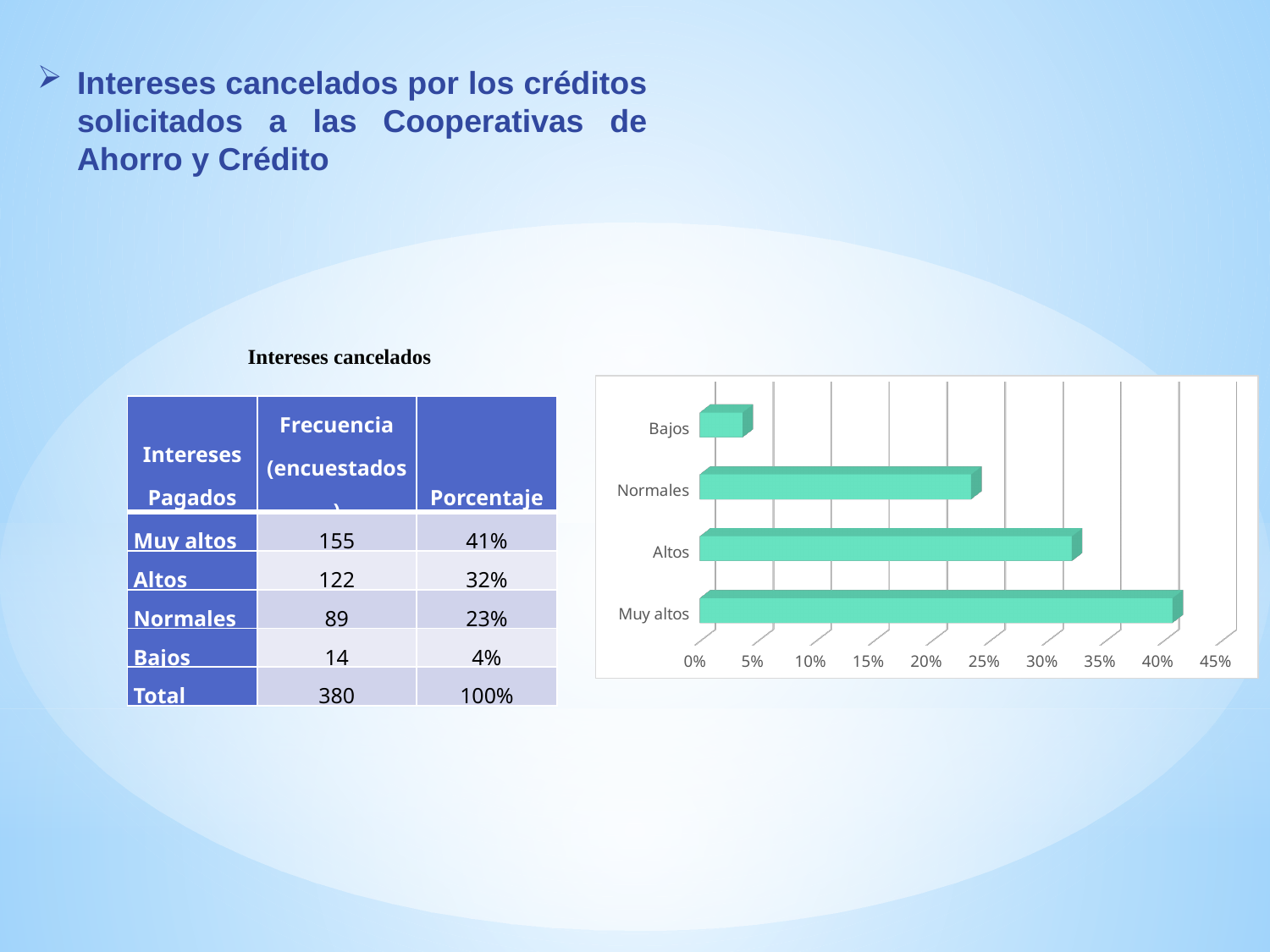
Is the value for Muy altos greater or less than 35%? greater According to the table, what percentage corresponds to Muy altos? 41% Is the value for Normales greater or less than 20%? greater How many categories does the bar chart show? 4 What is the highest value shown on the chart's horizontal axis? 45% According to the table, what is the difference in percentage between Muy altos and Bajos? 37% Is the value for Altos greater or less than 30%? greater Which category has the longest bar in the chart? Muy altos What kind of chart is shown on the slide? bar chart Which is larger in the chart, the value for Altos or the value for Normales? Altos Which category has the shortest bar in the chart? Bajos